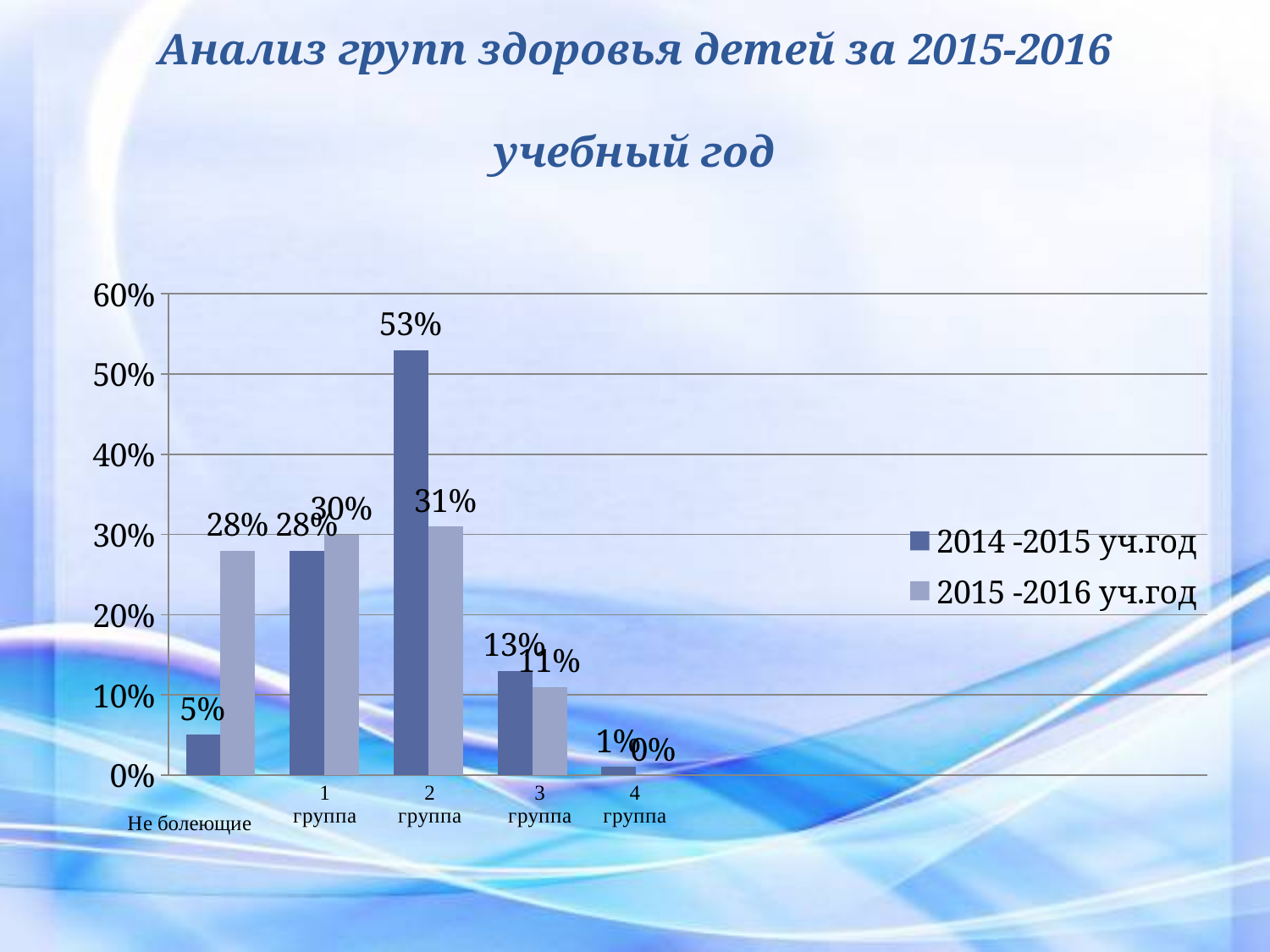
What is the value for 4 группа in the 2014 -2015 уч.год series? 1% Which category has the lowest value in the 2015 -2016 уч.год series? 4 группа Which is larger for Не болеющие: the 2014 -2015 уч.год value or the 2015 -2016 уч.год value? 2015 -2016 уч.год Which category has the highest value in the 2014 -2015 уч.год series? 2 группа What is the value for 3 группа in the 2015 -2016 уч.год series? 11% What is the value for Не болеющие in the 2015 -2016 уч.год series? 28% How many categories are shown on the x axis? 5 What kind of chart is shown on the slide? bar chart What is the difference between the 2014 -2015 уч.год and 2015 -2016 уч.год values for 2 группа? 22% What is the value for 2 группа in the 2014 -2015 уч.год series? 53% How many series does the legend list? 2 Is the value for 2 группа in the 2014 -2015 уч.год series greater or less than 50%? greater